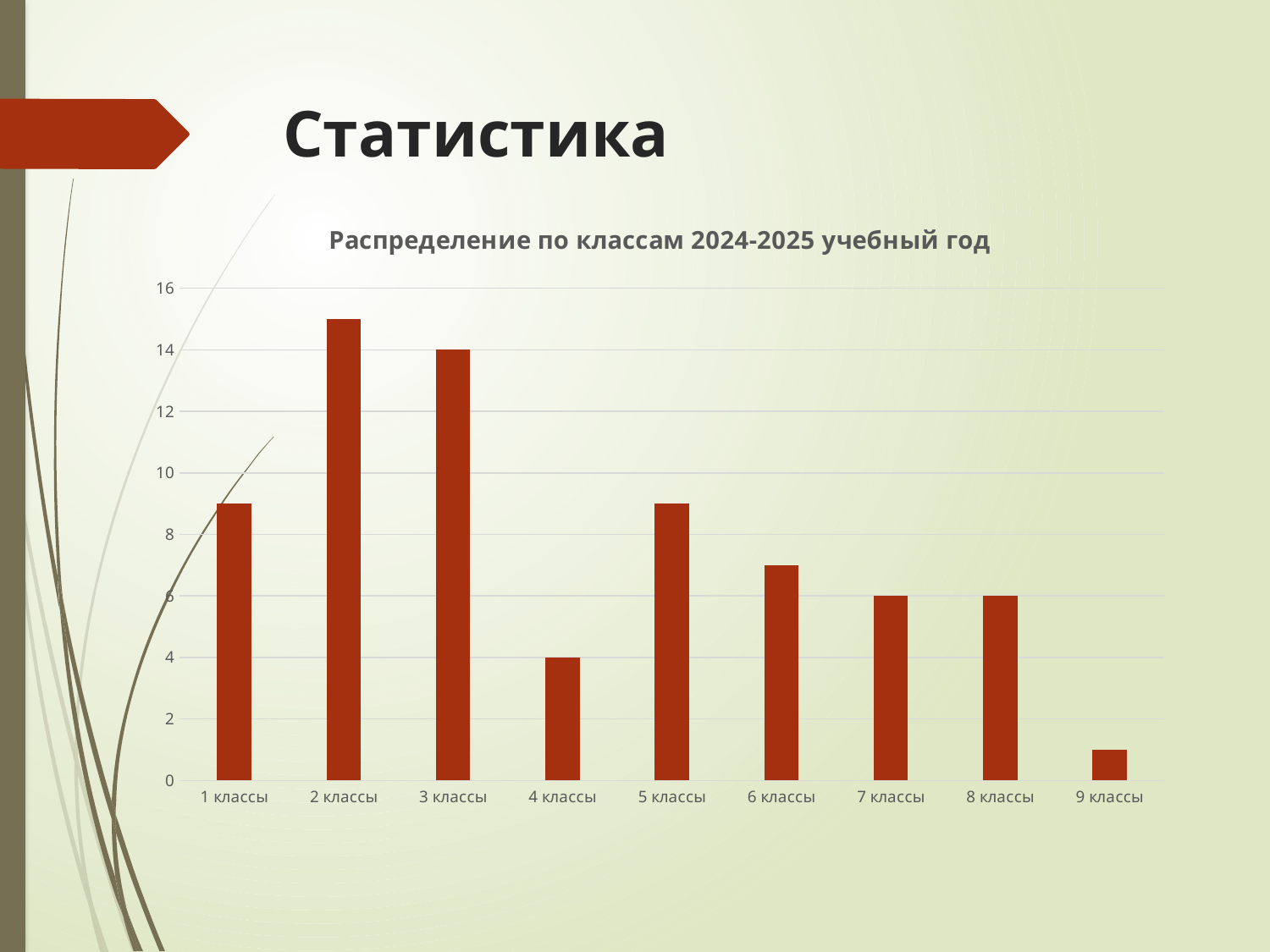
What type of chart is shown on the slide? bar chart Which category has the highest bar? 2 классы Which is larger, the value for 6 классы or the value for 7 классы? 6 классы What is the value for 3 классы? 14 Is the value for 9 классы greater or less than 2? less How many categories are shown on the x axis of the chart? 9 Is the value for 2 классы greater or less than 14? greater What is the difference between the values for 3 классы and 4 классы? 10 Which category has the lowest bar? 9 классы What is the value for 7 классы? 6 What is the value for 4 классы? 4 What is the title of the chart? Распределение по классам 2024-2025 учебный год